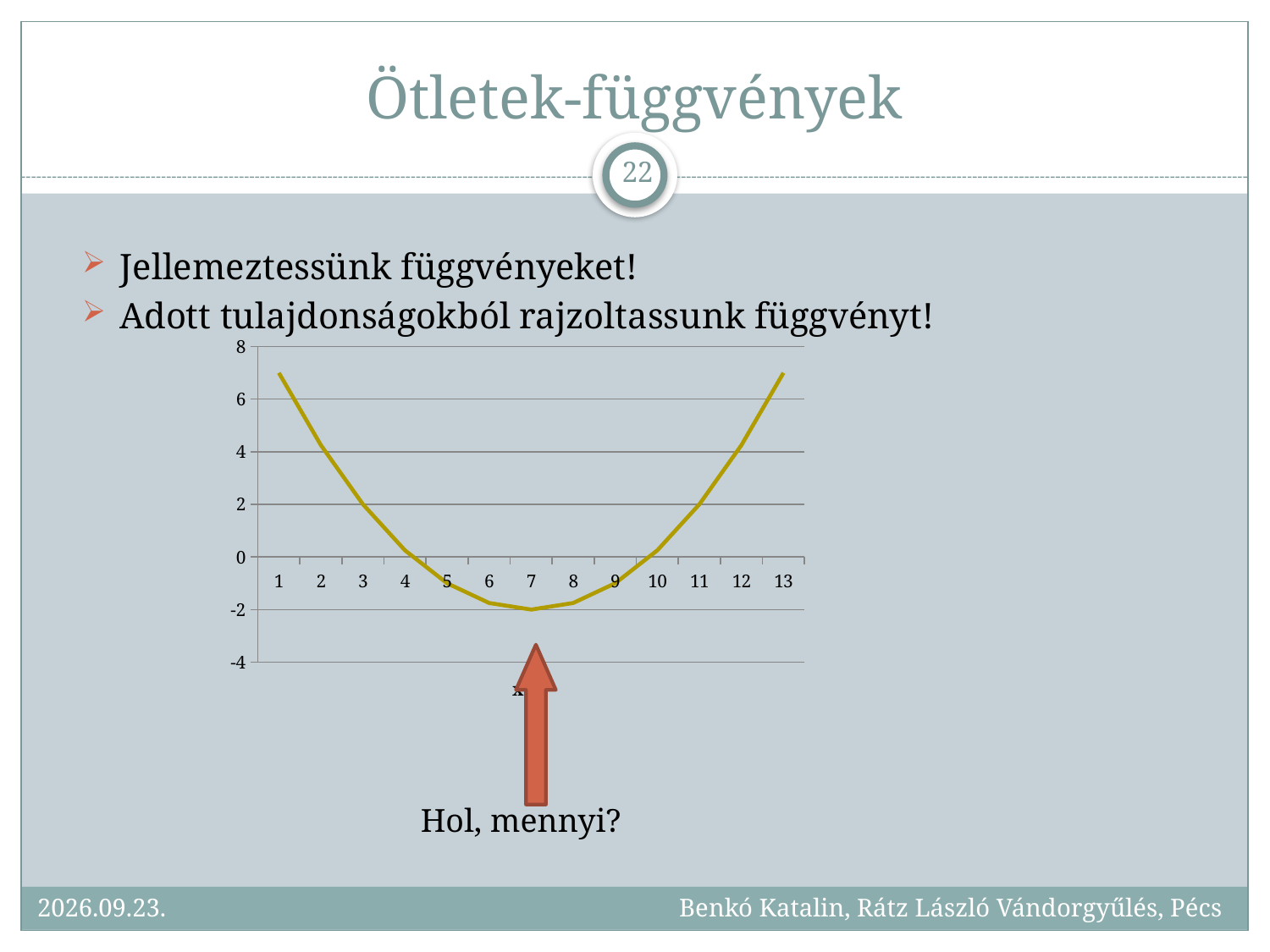
Do the values rise or fall as x goes from 7 to 13? rise Is the value of the curve at x = 10 greater or less than 2? less What kind of chart is shown on the slide? line chart Is the value of the curve at x = 13 greater or less than 4? greater Which has the larger value, x = 1 or x = 7? x = 1 Do the values rise or fall as x goes from 1 to 7? fall Is the value of the curve at x = 1 greater or less than 6? greater At which x value does the curve reach its lowest point? 7 Which has the larger value, x = 3 or x = 5? x = 3 How many x-axis points are labelled on the chart? 13 What is the value of the curve at x = 7? -2